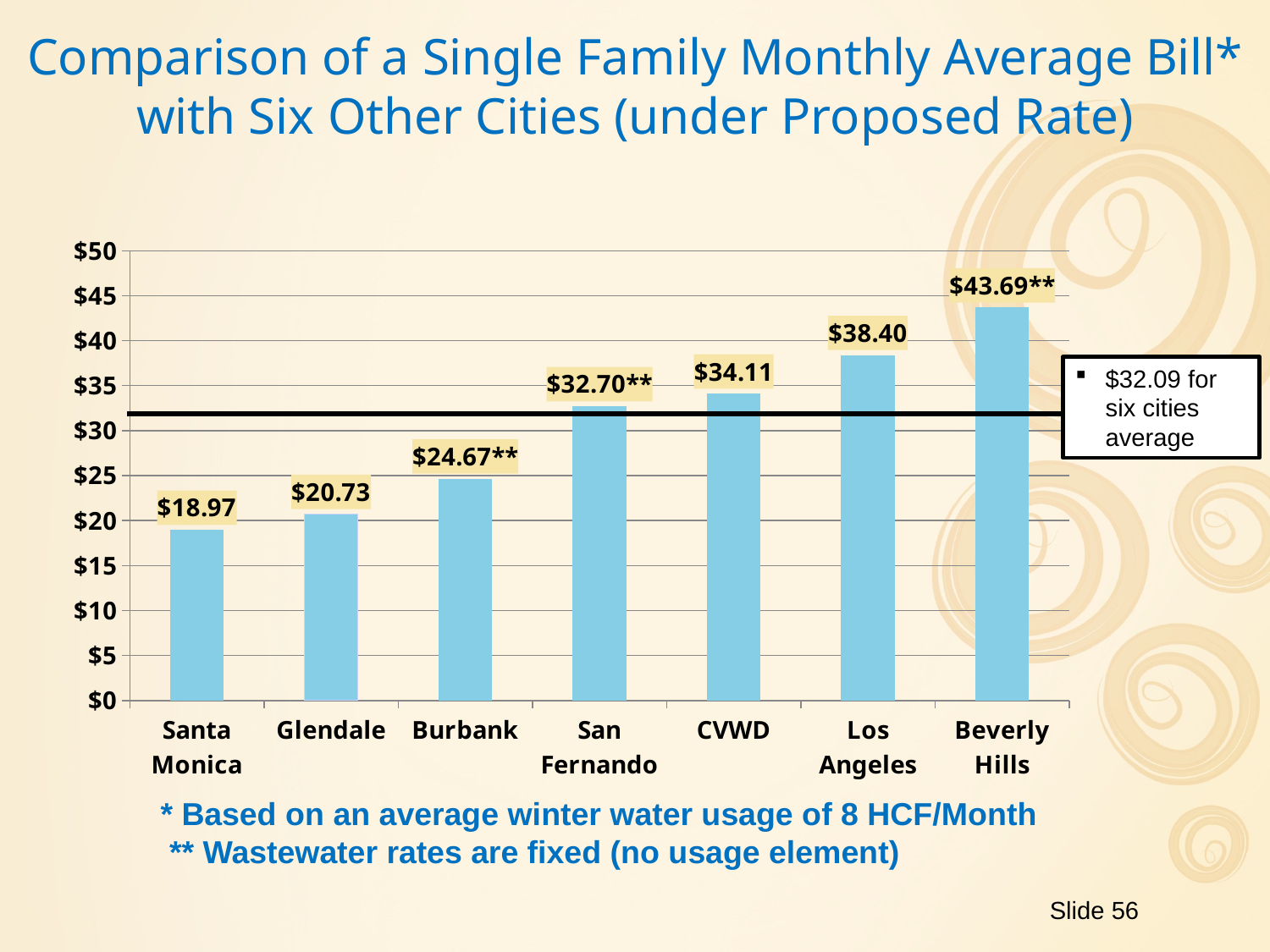
Which is larger, the bill for Burbank or the bill for San Fernando? San Fernando Which city has the lowest monthly average bill? Santa Monica How many cities are shown on the chart? 7 What is the monthly average bill for CVWD? $34.11 What value does the horizontal line across the chart represent? $32.09 for six cities average What is the monthly average bill for Los Angeles? $38.40 What is the difference between the Los Angeles bill and the CVWD bill? $4.29 What kind of chart is shown on the slide? Bar chart What is the monthly average bill for Santa Monica? $18.97 What is the difference between the Glendale bill and the Santa Monica bill? $1.76 Which city has the highest monthly average bill? Beverly Hills What is the monthly average bill for Glendale? $20.73